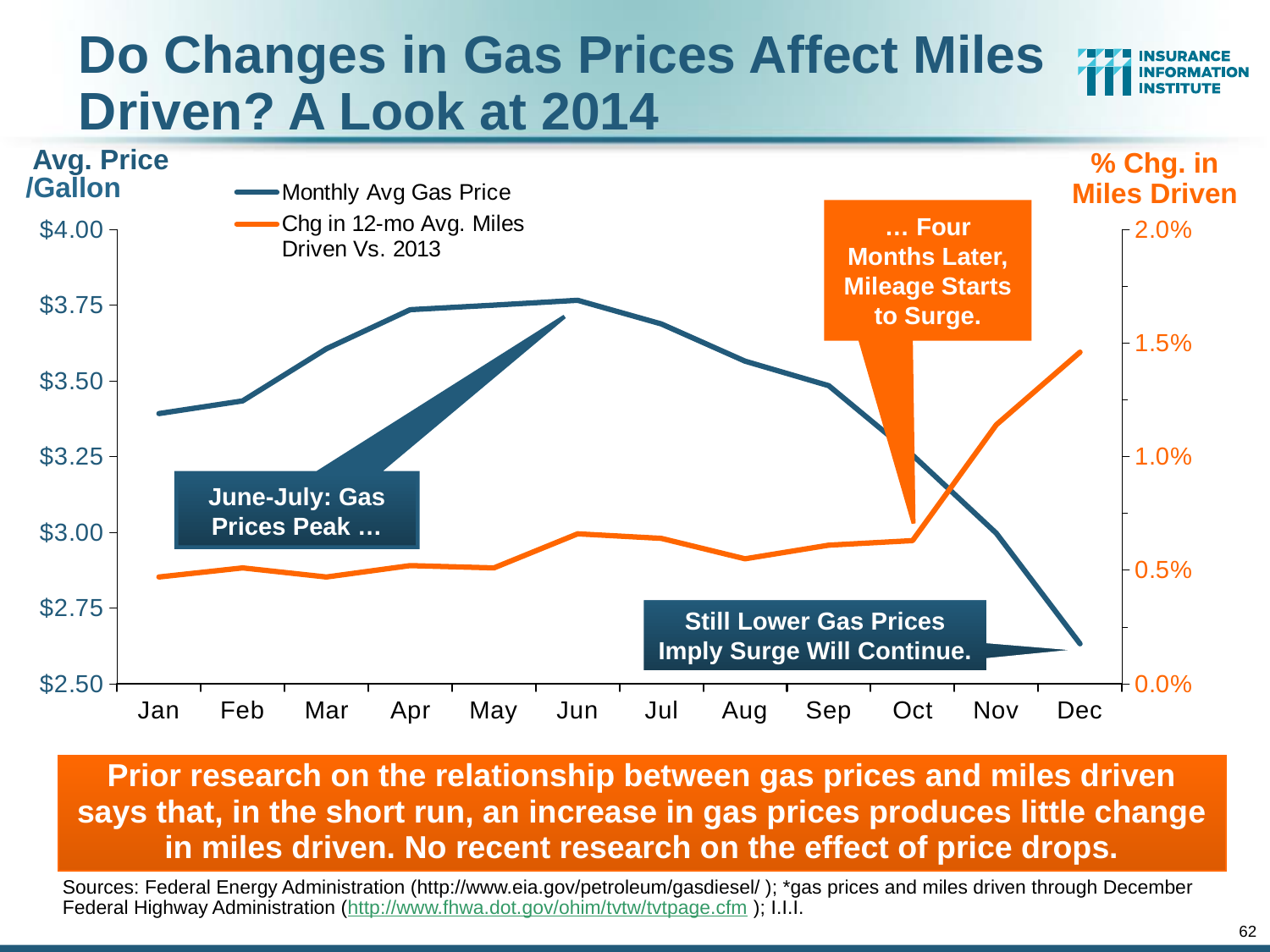
Is the Monthly Avg Gas Price for Dec greater or less than $2.75? less Which axis label appears on the right side of the chart? % Chg. in Miles Driven How many series does the chart legend list? 2 In which month is the Monthly Avg Gas Price lowest? Dec How many months are plotted along the x axis? 12 Which month has the higher Monthly Avg Gas Price, Jan or Dec? Jan Is the Chg in 12-mo Avg. Miles Driven Vs. 2013 for Dec greater or less than 1.0%? greater What kind of chart is shown on the slide? line chart Does the Monthly Avg Gas Price rise or fall from Jun to Dec? fall Is the Chg in 12-mo Avg. Miles Driven Vs. 2013 for Jan greater or less than 1.0%? less In which month is the Chg in 12-mo Avg. Miles Driven Vs. 2013 highest? Dec